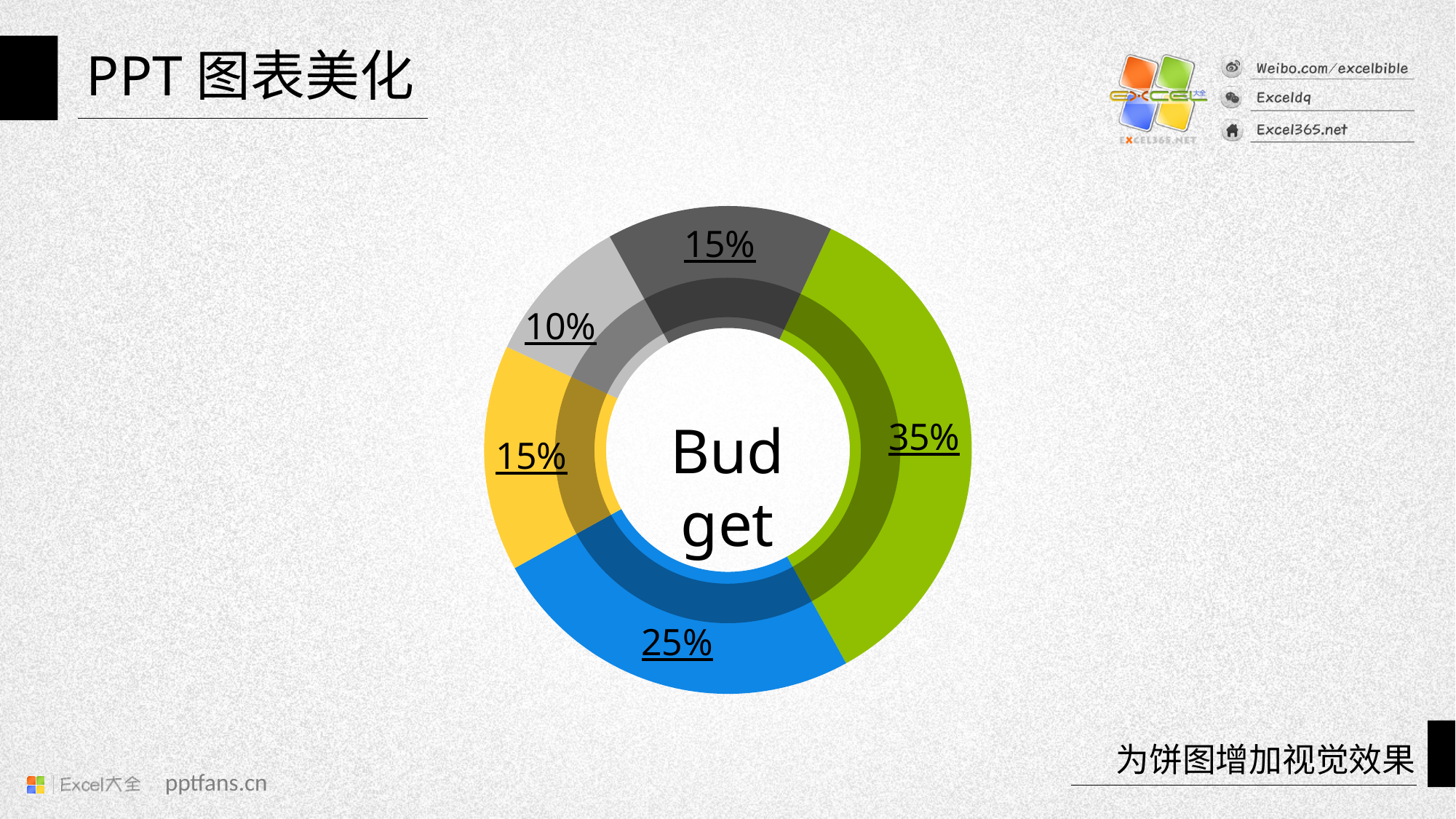
What percentage is shown on the blue slice? 25% What text appears in the centre of the doughnut chart? Budget What is the difference between the green slice and the blue slice? 10% What percentage is shown on the green slice? 35% What percentage is shown on the yellow slice? 15% Which is larger, the blue slice or the yellow slice? Blue What percentage is shown on the light gray slice? 10% Which colour slice has the largest share of the doughnut chart? Green How many slices does the doughnut chart have? 5 What kind of chart is shown on the slide? Doughnut chart Which colour slice has the smallest share of the doughnut chart? Light gray What percentage is shown on the dark gray slice? 15%